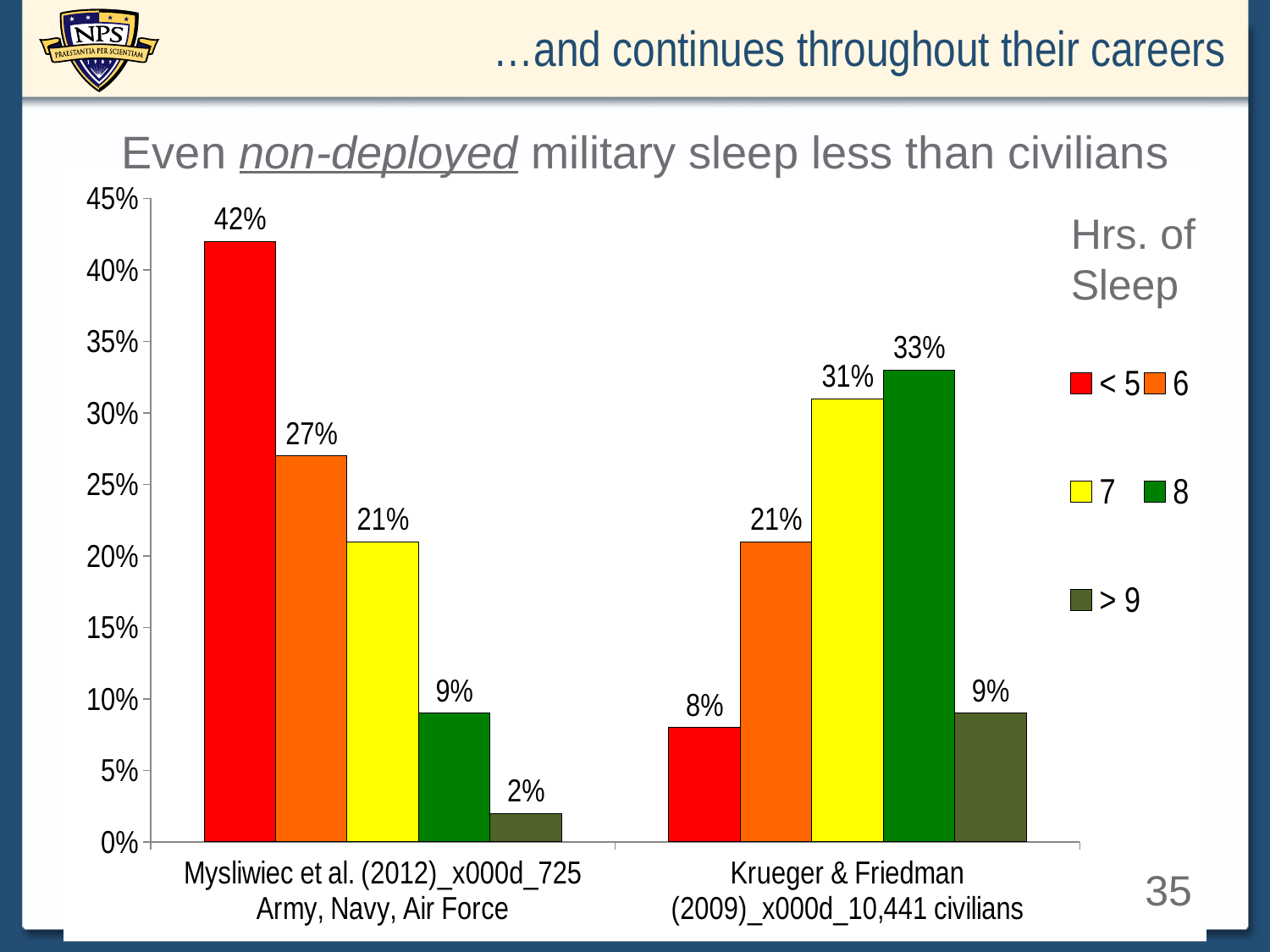
How many series does the legend list? 5 What percentage of the Krueger & Friedman (2009) civilians sleep less than 5 hours? 8% What colour represents the '< 5' hours of sleep series? Red What is the difference between the percentage of military personnel and civilians sleeping less than 5 hours? 34% How many groups (categories) are shown on the x axis? 2 What percentage of the Krueger & Friedman (2009) civilians sleep 8 hours? 33% Which sleep-hours category has the highest percentage among the Krueger & Friedman (2009) civilians? 8 What kind of chart is shown on the slide? Bar chart Which sleep-hours category has the lowest percentage among the Mysliwiec et al. (2012) military sample? > 9 What percentage of the Mysliwiec et al. (2012) military sample sleeps less than 5 hours? 42% What percentage of the Mysliwiec et al. (2012) military sample sleeps more than 9 hours? 2% Which group has a larger share sleeping 7 hours, the Mysliwiec et al. (2012) military sample or the Krueger & Friedman (2009) civilians? Krueger & Friedman (2009) civilians